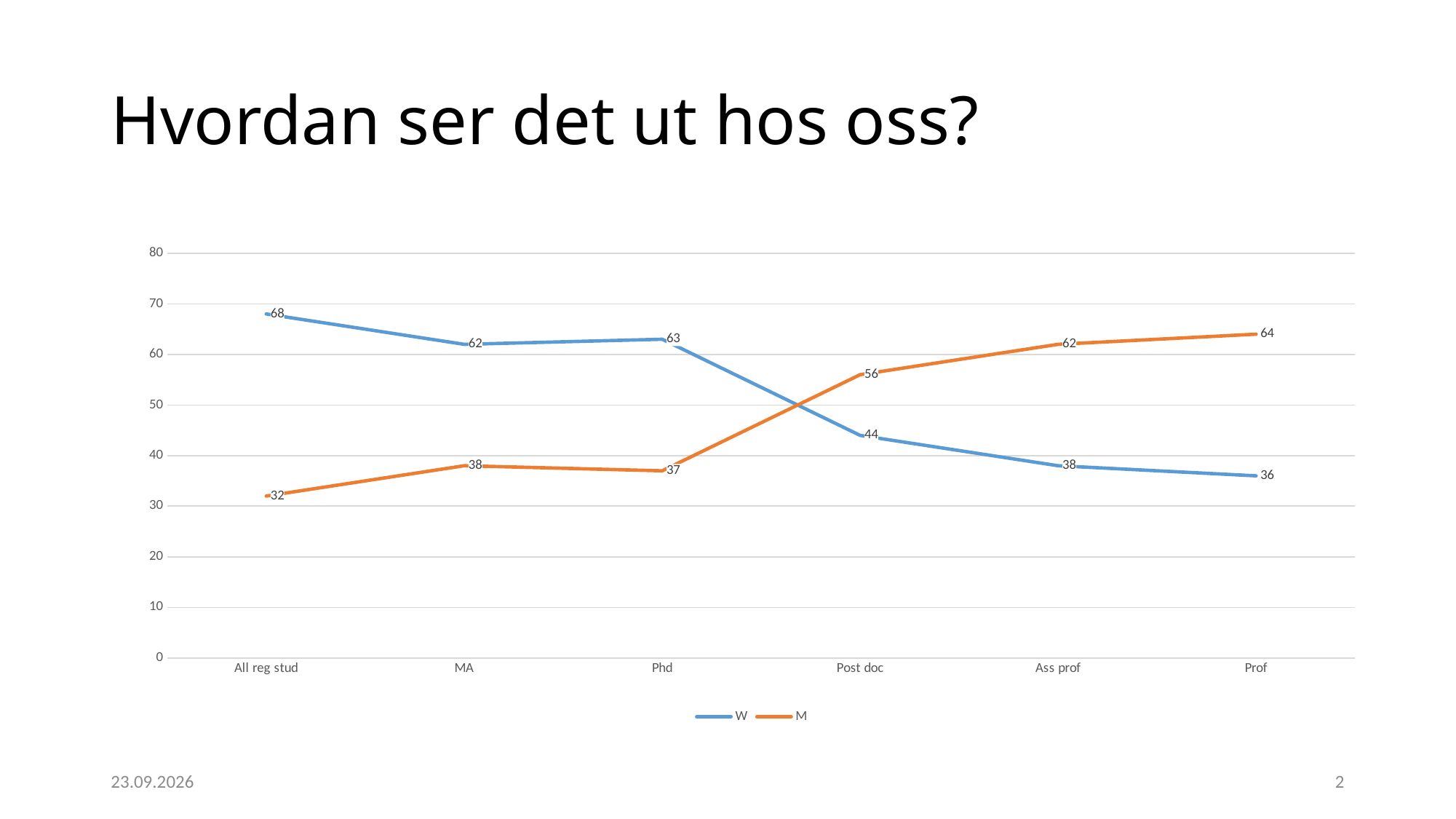
How many categories are shown on the x axis? 6 What is the value for M at Prof? 64 What is the value for W at Phd? 63 How many series does the legend list? 2 At which category is the W series highest? All reg stud What is the value for M at All reg stud? 32 What is the difference between W and M at Ass prof? 24 At which category is the M series lowest? All reg stud Does the M series rise or fall from All reg stud to Prof? Rise Which is larger at Phd, W or M? W What kind of chart is shown on the slide? Line chart What is the value for W at Post doc? 44